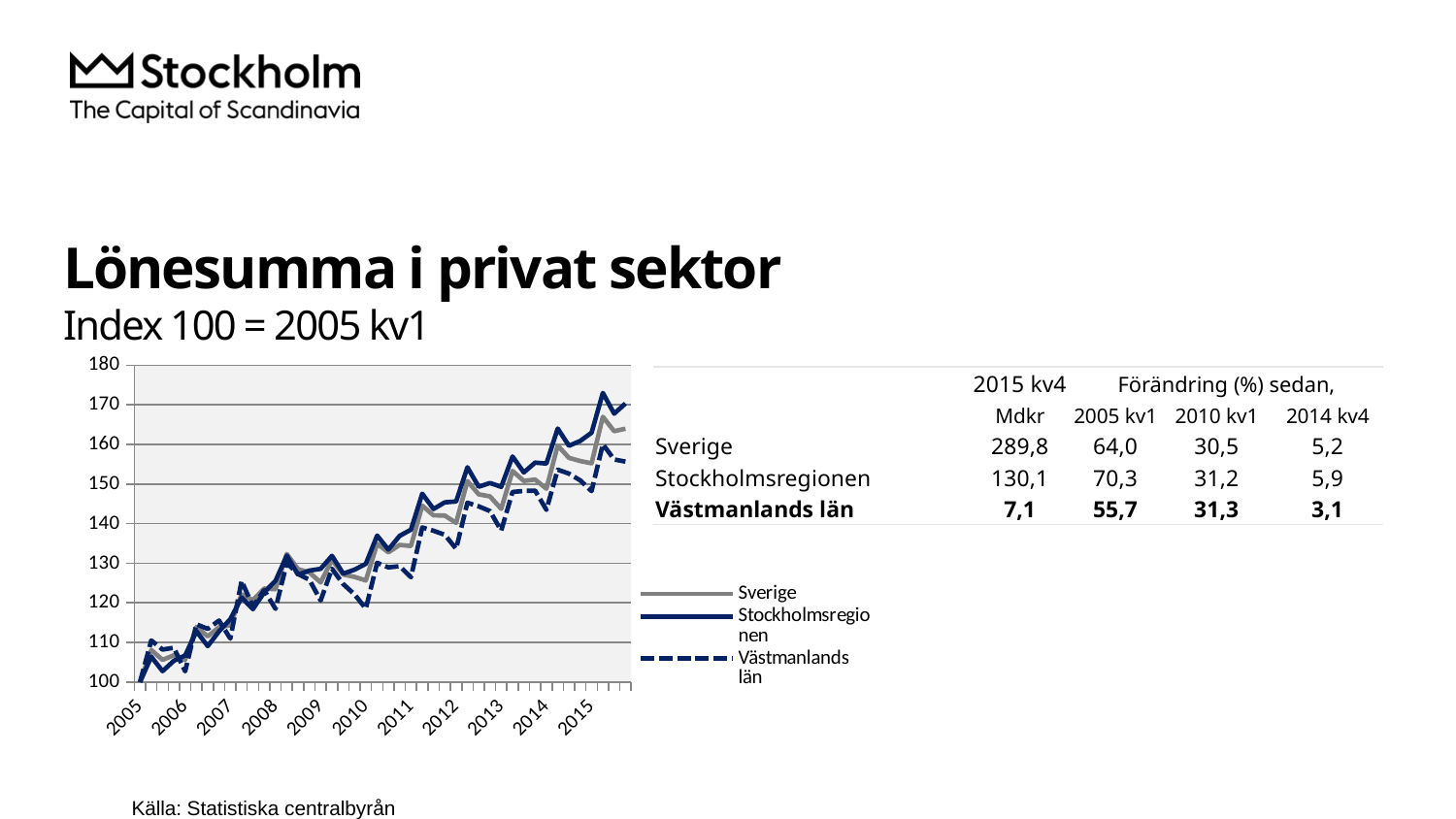
Do the values in the chart generally rise or fall from 2005 to 2015? rise What is the title of the chart? Lönesumma i privat sektor Which series has the highest value at the end of 2015? Stockholmsregionen Which series has the lowest value at the end of 2015? Västmanlands län How many series does the chart's legend list? 3 What is the base period of the index used in the chart? Index 100 = 2005 kv1 Is the value for Stockholmsregionen at the 2012 tick greater or less than 140? greater Is the value for Sverige at the end of 2015 greater or less than 150? greater Is the value for Västmanlands län at the start of 2005 greater or less than 110? less What type of chart is shown on the slide? line chart How many year labels are shown on the x axis of the chart? 11